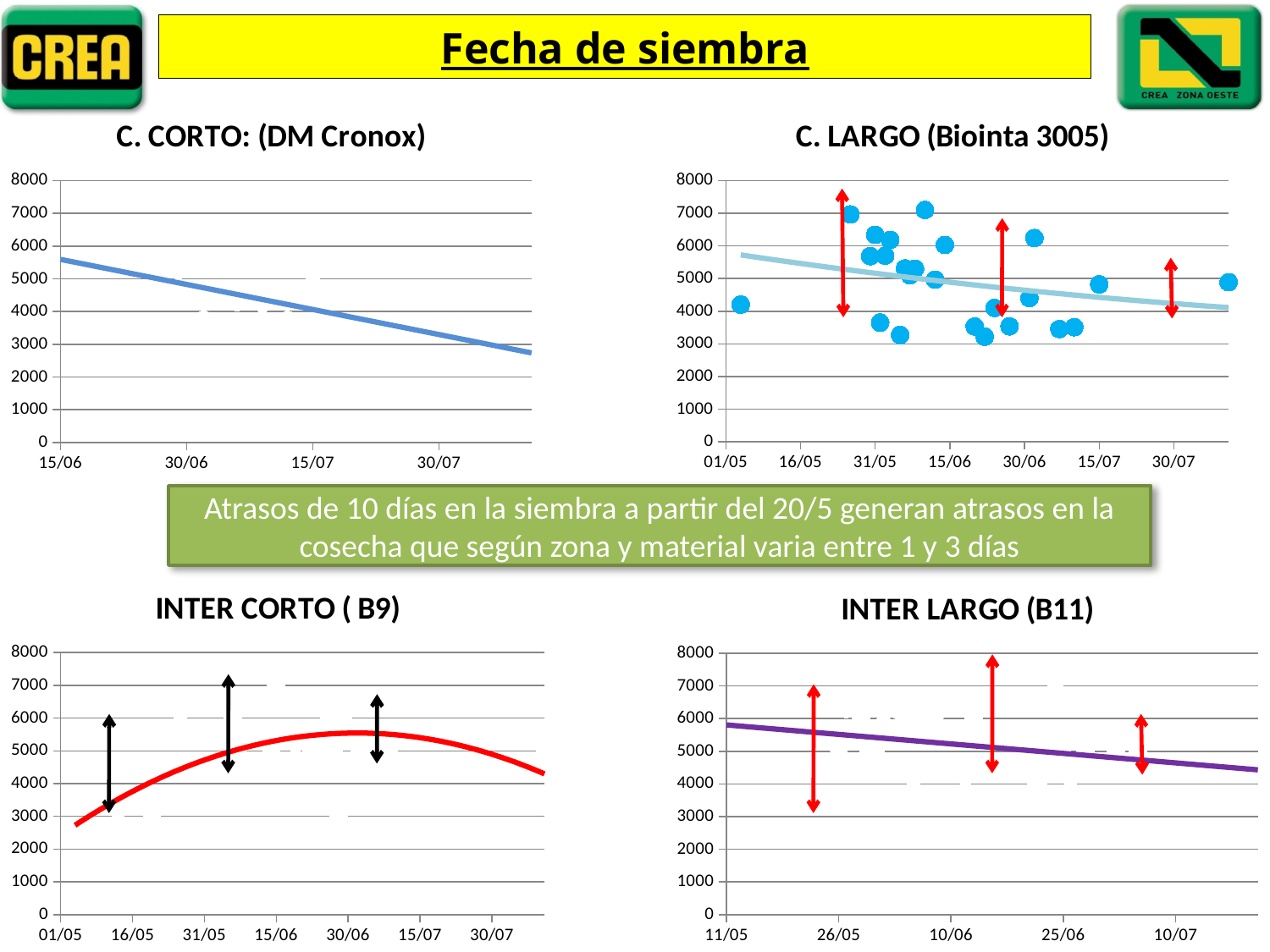
In the 'INTER CORTO ( B9)' chart, is the value at 01/05 greater or less than 3000? less How many charts are shown on the slide? 4 In the 'INTER CORTO ( B9)' chart, how does the curve behave from 01/05 to 30/07? rises then falls In the 'C. CORTO: (DM Cronox)' chart, is the value at 15/06 greater or less than 5000? greater In the 'C. LARGO (Biointa 3005)' chart, does the trend line rise or fall from 01/05 to 30/07? fall In the 'C. CORTO: (DM Cronox)' chart, do the values rise or fall from 15/06 to 30/07? fall What kind of chart is the 'C. CORTO: (DM Cronox)' chart? line chart In the 'C. CORTO: (DM Cronox)' chart, is the value at 30/07 greater or less than 4000? less What is the highest value shown on the y axis of the 'INTER CORTO ( B9)' chart? 8000